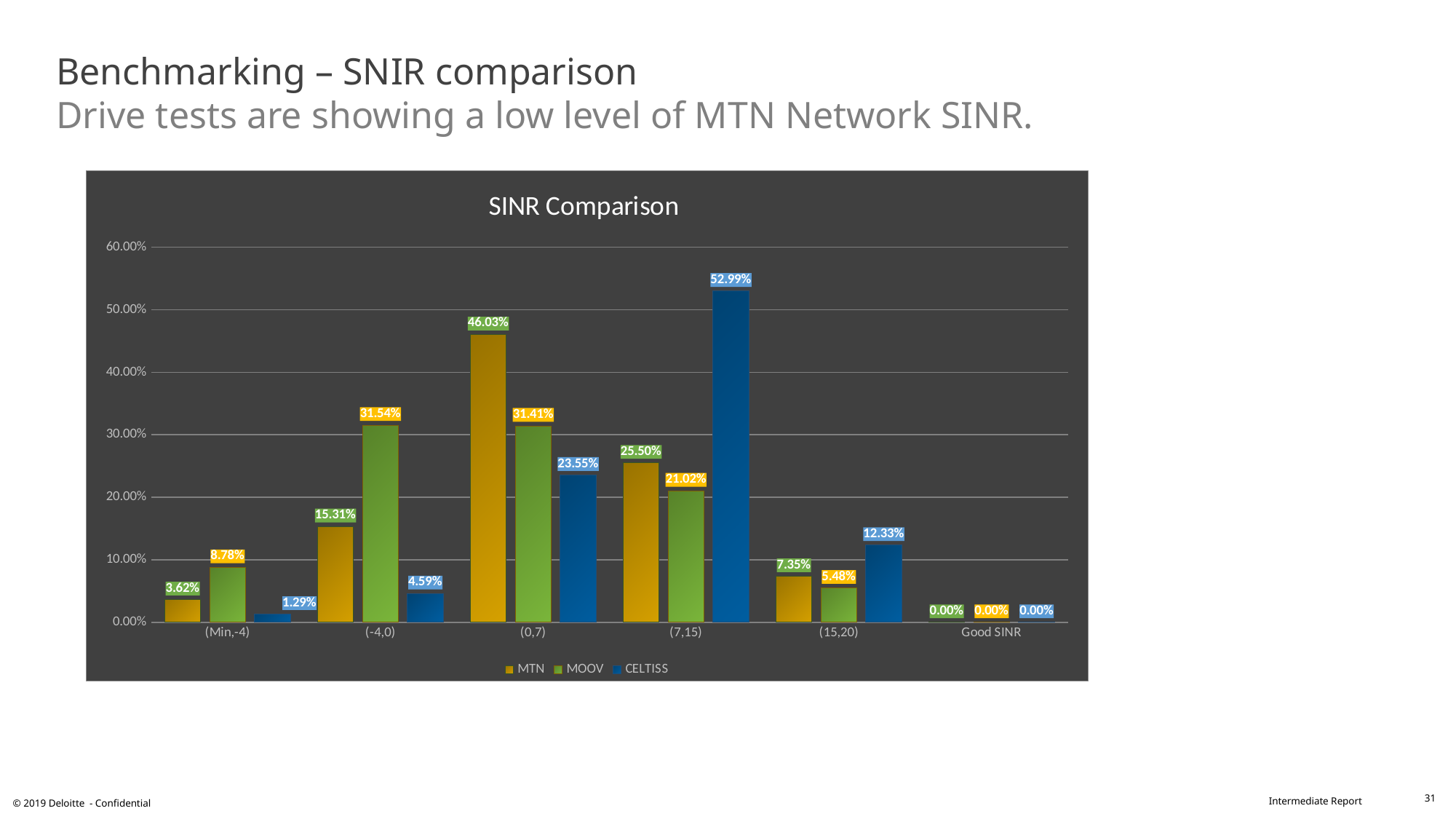
What is the title of the chart? SINR Comparison What is the difference between the MTN and MOOV values in the (0,7) category? 14.62% What is the value for MOOV in the (-4,0) category? 31.54% Which series has the lowest value in the (Min,-4) category? CELTISS What is the value for MTN in the (0,7) category? 46.03% Which is larger in the (15,20) category, the MTN value or the CELTISS value? CELTISS What is the value for CELTISS in the (7,15) category? 52.99% What is the value for all three series in the Good SINR category? 0.00% How many series does the legend of the SINR Comparison chart list? 3 What type of chart is shown on the slide? bar chart In which category does CELTISS reach its highest value? (7,15) How many categories are shown on the x axis of the SINR Comparison chart? 6